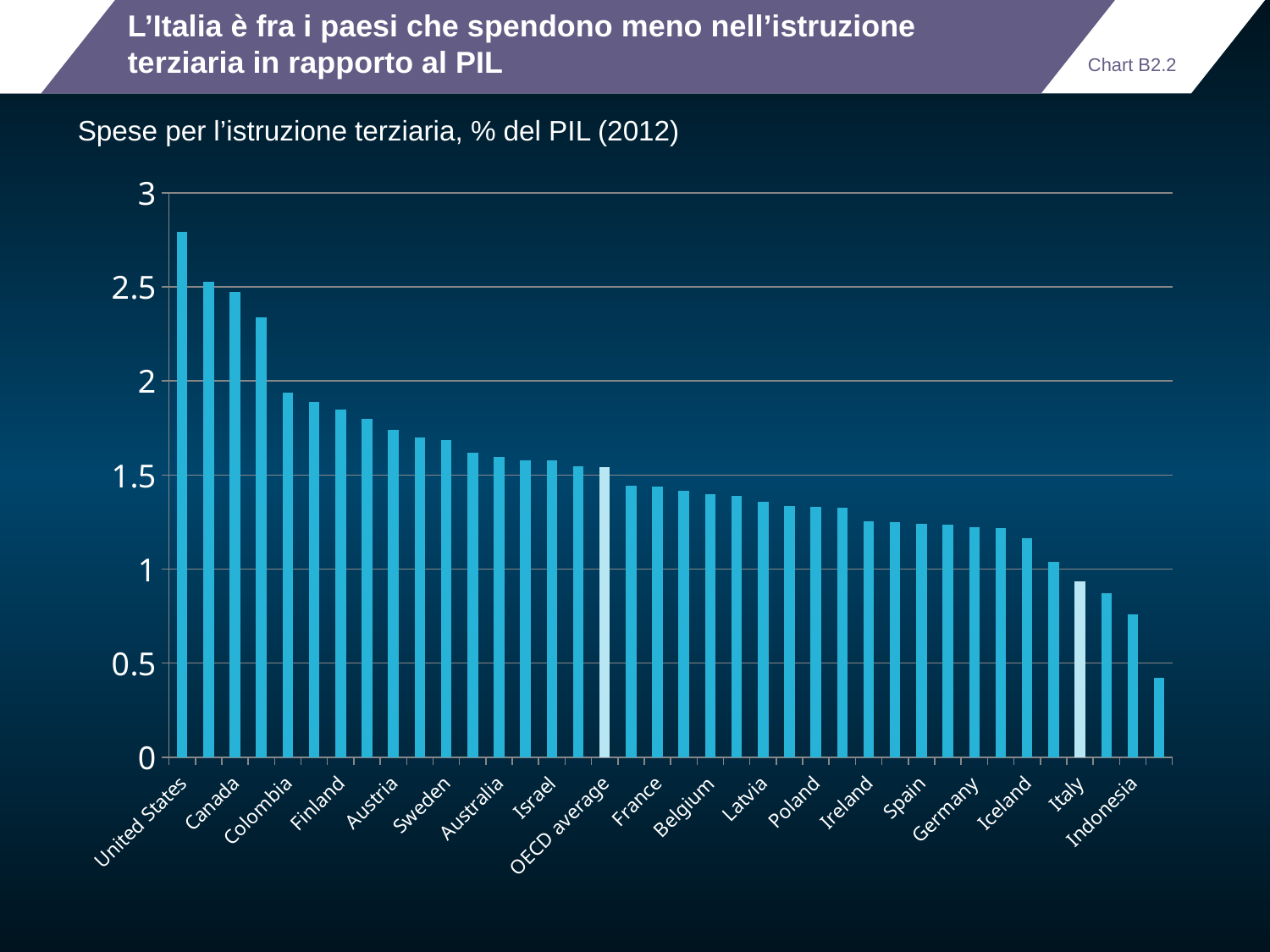
Is the value for France greater or less than 1.5? less Which is larger, the value for Colombia or the value for Finland? Colombia Is the value for United States greater or less than 2.5? greater Is the value for Colombia greater or less than 2? less What kind of chart is shown on the slide? Bar chart What is the subtitle describing the chart's data? Spese per l'istruzione terziaria, % del PIL (2012) Do the values rise or fall from left to right along the x axis? Fall Which country has the highest tertiary education spending as % of GDP? United States